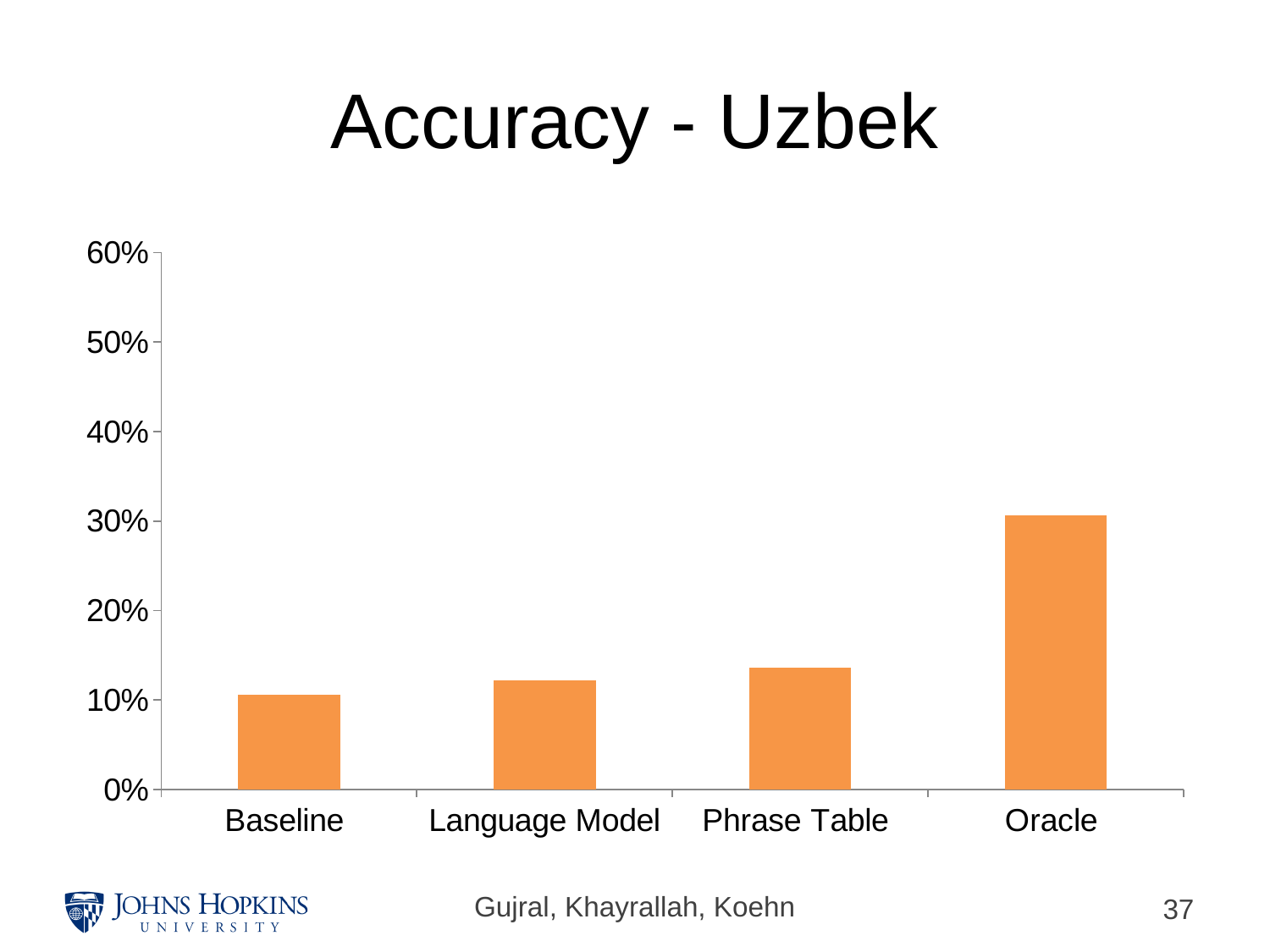
Is the value for Oracle greater or less than 40%? less What kind of chart is shown on the slide? bar chart Which has a higher accuracy, Oracle or Phrase Table? Oracle Is the value for Oracle greater or less than 20%? greater Is the value for Phrase Table greater or less than 10%? greater Which has a higher accuracy, Baseline or Oracle? Oracle Which category has the lowest accuracy? Baseline What is the title of the chart? Accuracy - Uzbek How many categories are shown on the x axis of the chart? 4 Which category has the highest accuracy? Oracle Do the accuracy values rise or fall from Baseline to Oracle along the x axis? rise